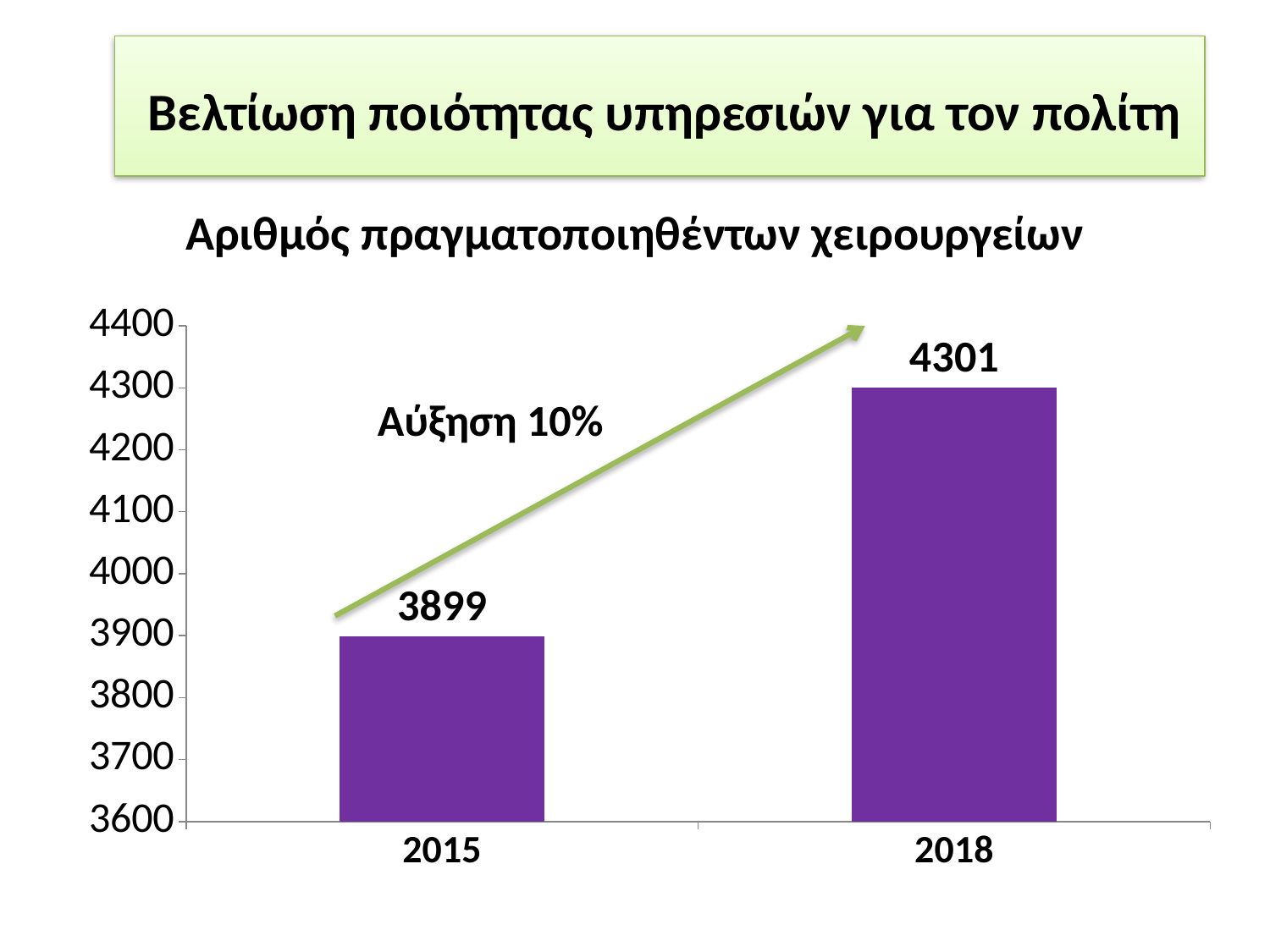
What is the value for 2015? 3899 What percentage increase is annotated on the chart? 10% Is the value for 2015 greater or less than 4000? less Do the values rise or fall from 2015 to 2018? rise What is the value for 2018? 4301 What is the title of the chart? Αριθμός πραγματοποιηθέντων χειρουργείων How many categories are shown on the x axis? 2 Which year has the lower value? 2015 What is the difference between the values for 2018 and 2015? 402 Which year has the higher value? 2018 Is the value for 2018 greater or less than 4200? greater What kind of chart is shown on the slide? bar chart